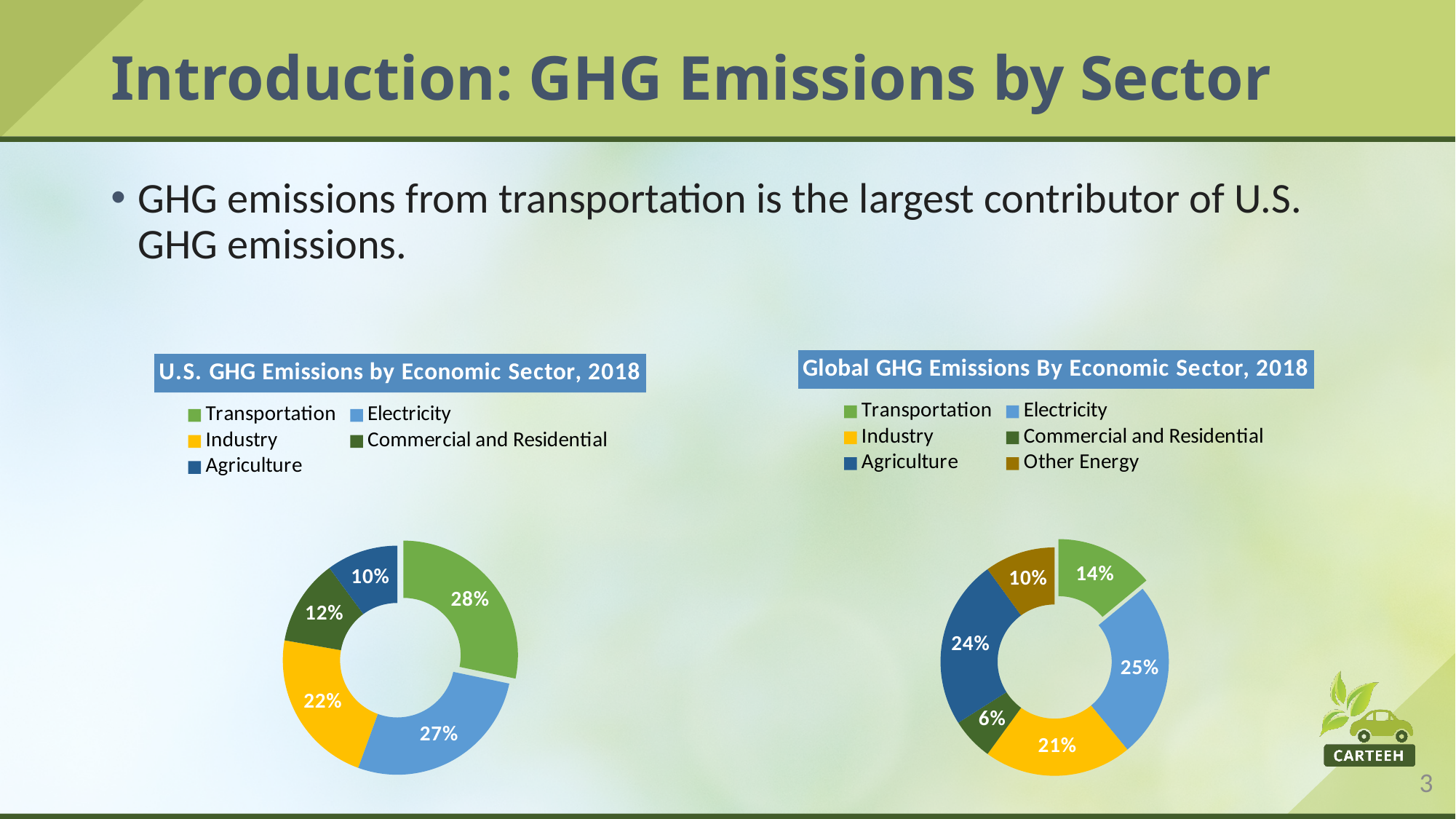
In the U.S. GHG Emissions by Economic Sector, 2018 chart, which sector has the largest share? Transportation In the Global GHG Emissions By Economic Sector, 2018 chart, which is larger: Agriculture or Industry? Agriculture What kind of chart is the U.S. GHG Emissions by Economic Sector, 2018 chart? Pie (doughnut) chart In the Global GHG Emissions By Economic Sector, 2018 chart, what share is Electricity? 25% How many slices does the U.S. GHG Emissions by Economic Sector, 2018 chart have? 5 In the Global GHG Emissions By Economic Sector, 2018 chart, which sector has the largest share? Electricity In the U.S. GHG Emissions by Economic Sector, 2018 chart, what share is Transportation? 28% How many sectors does the legend of the Global GHG Emissions By Economic Sector, 2018 chart list? 6 In the Global GHG Emissions By Economic Sector, 2018 chart, which sector has the smallest share? Commercial and Residential In the U.S. GHG Emissions by Economic Sector, 2018 chart, what share is Agriculture? 10% In the U.S. GHG Emissions by Economic Sector, 2018 chart, what is the difference between the Industry share and the Commercial and Residential share? 10% In the Global GHG Emissions By Economic Sector, 2018 chart, what share is Commercial and Residential? 6%